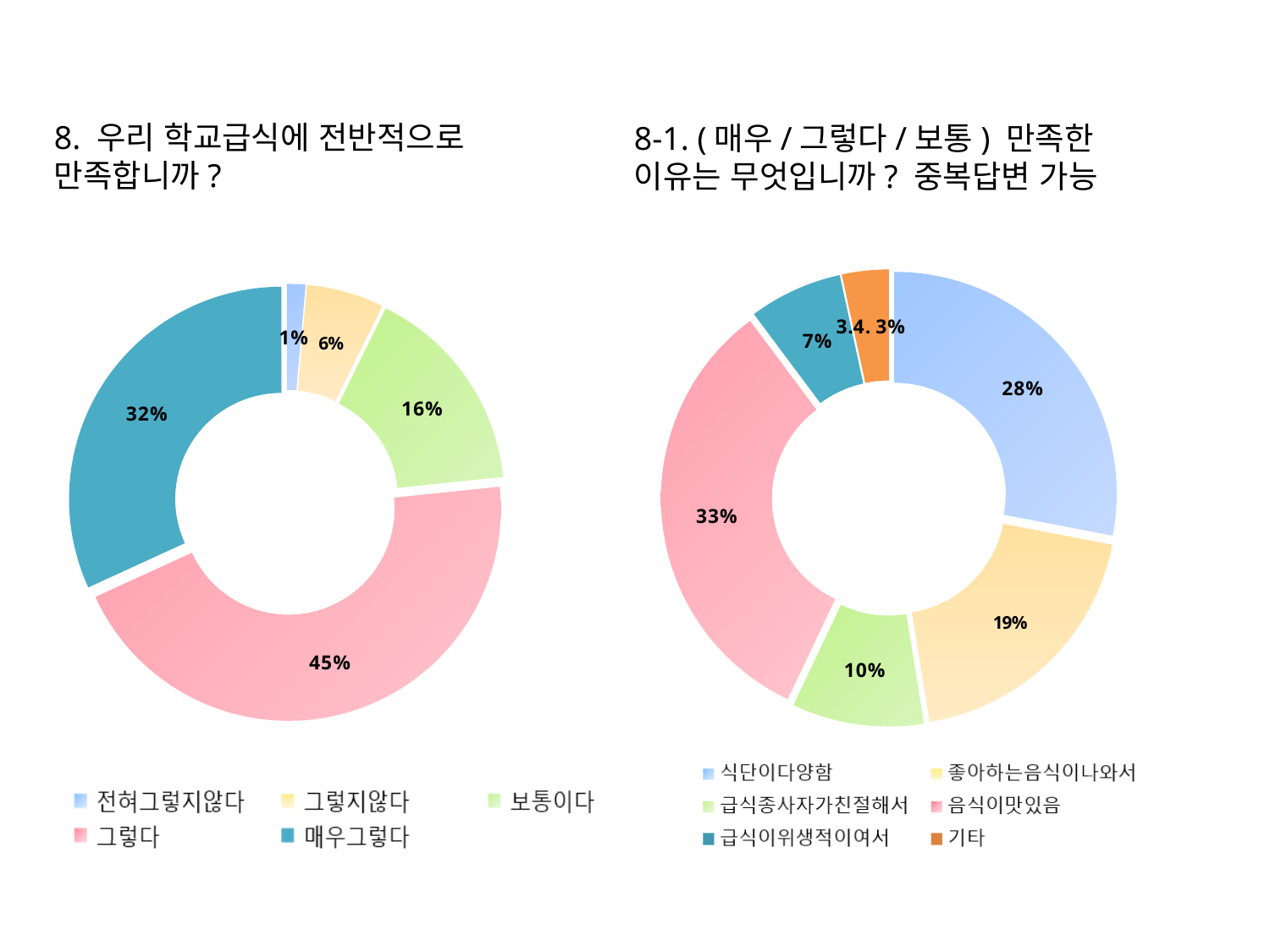
In the right chart (question 8-1), which is larger, 좋아하는음식이나와서 or 급식종사자가친절해서? 좋아하는음식이나와서 In the left chart (question 8), what percentage is shown for 그렇다? 45% In the left chart (question 8), which category has the largest share? 그렇다 In the right chart (question 8-1), what is the difference between the shares for 음식이맛있음 and 식단이다양함? 5% In the left chart (question 8), how many categories does the legend list? 5 In the left chart (question 8), what is the difference between the shares for 그렇다 and 매우그렇다? 13% In the right chart (question 8-1), what percentage is shown for 음식이맛있음? 33% In the right chart (question 8-1), how many categories does the legend list? 6 What kind of chart is used for question 8 on the left? Doughnut (pie) chart In the left chart (question 8), which category has the smallest share? 전혀그렇지않다 In the right chart (question 8-1), what percentage is shown for 식단이다양함? 28% In the left chart (question 8), what percentage is shown for 매우그렇다? 32%